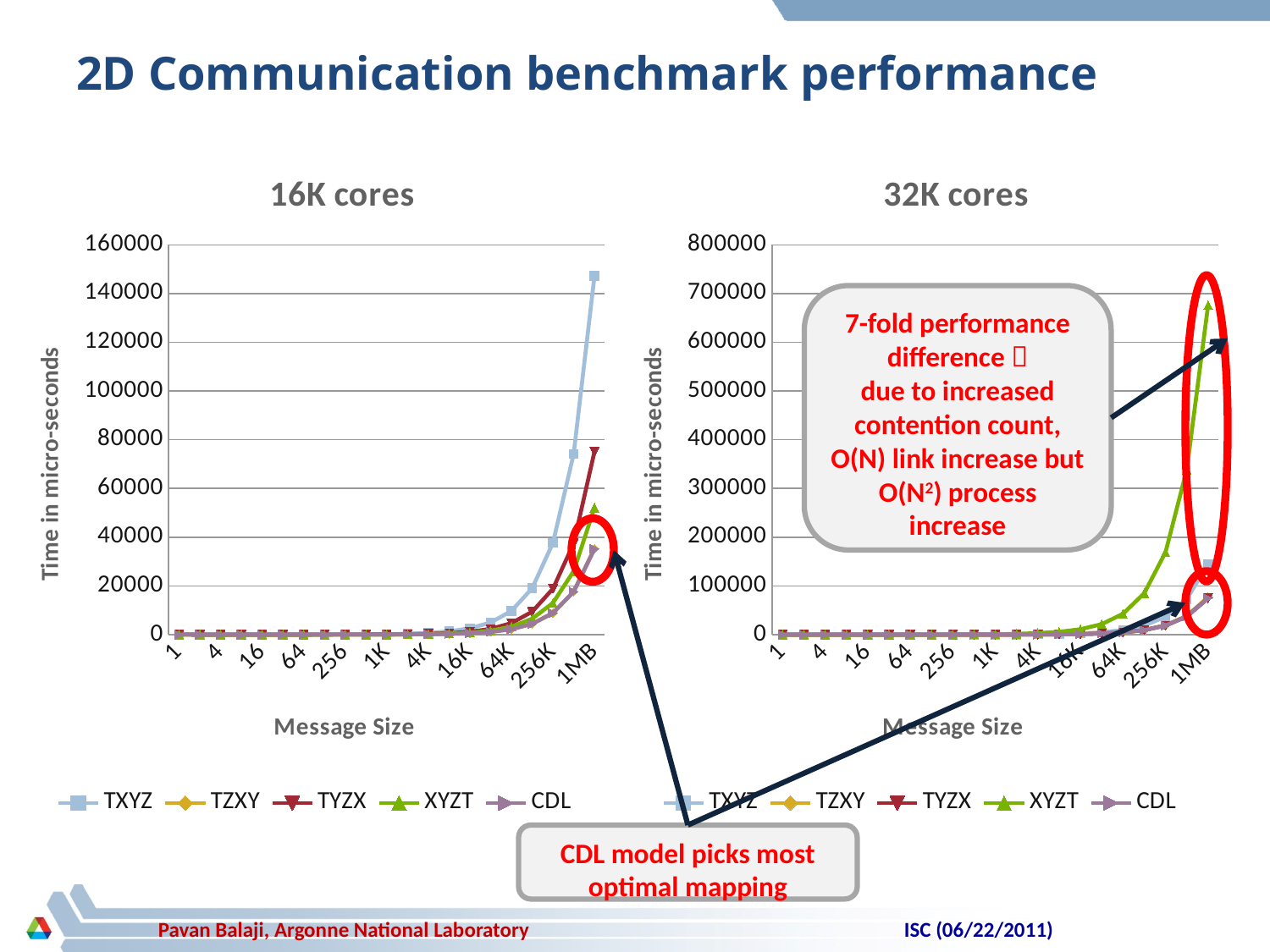
In the "16K cores" chart, is the value for TYZX at 1MB greater or less than 60000? greater How many series does the legend of the "32K cores" chart list? 5 In the "16K cores" chart, which is larger at 1MB, TXYZ or TYZX? TXYZ What is the x-axis label of the "32K cores" chart? Message Size In the "32K cores" chart, do the values for XYZT rise or fall as message size increases? rise In the "16K cores" chart, is the value for TXYZ at 1MB greater or less than 120000? greater What is the y-axis label of the "16K cores" chart? Time in micro-seconds What kind of chart is the "16K cores" chart? line chart In the "16K cores" chart, which series has the highest value at 1MB? TXYZ In the "32K cores" chart, is the value for TXYZ at 1MB greater or less than 200000? less In the "32K cores" chart, which series has the highest value at 1MB? XYZT